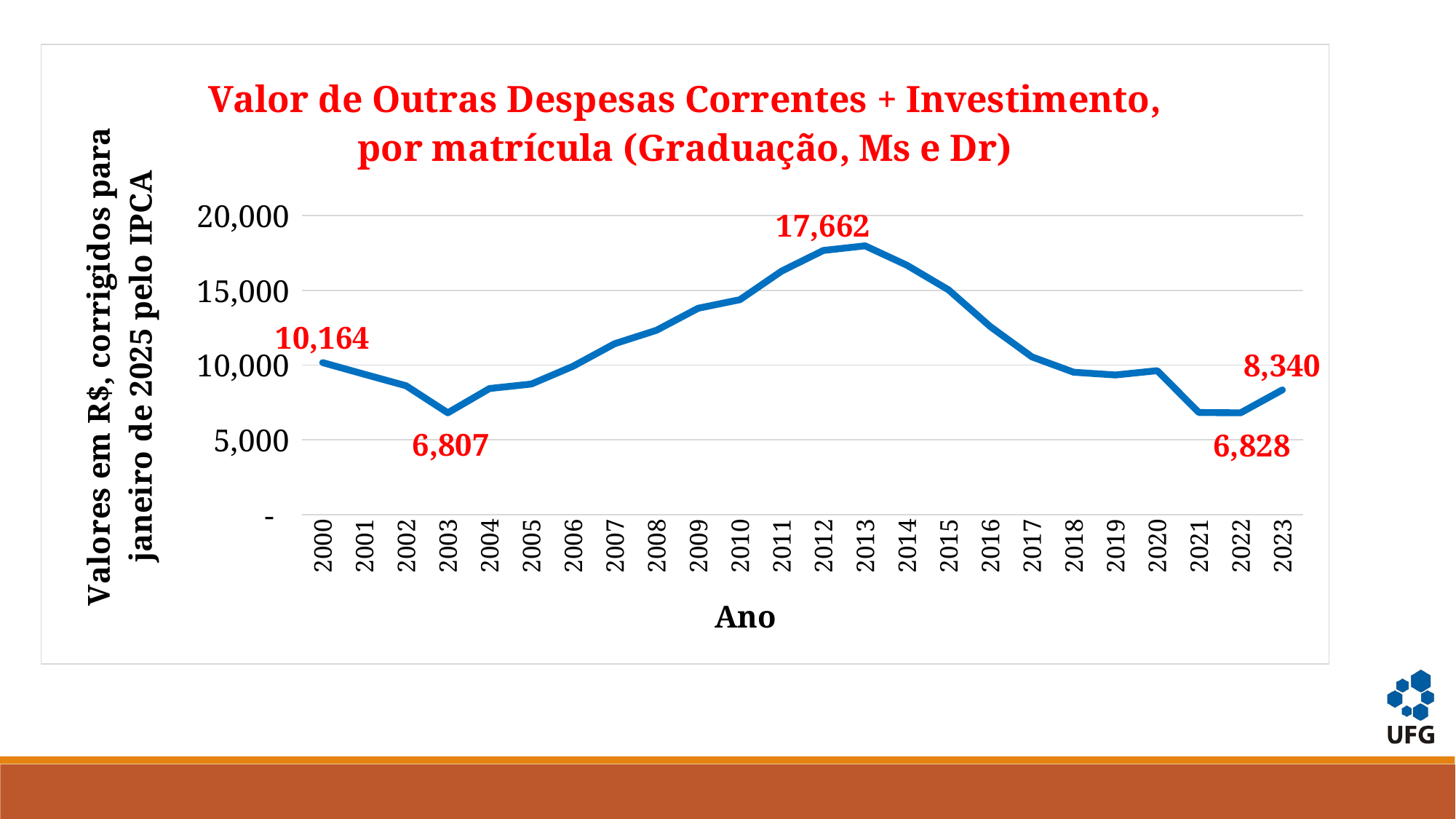
Which is larger, the value for 2000 or the value for 2023? 2000 What is the value for 2023? 8,340 What is the value for 2000? 10,164 Which year has the highest value? 2013 What kind of chart is this? line chart Is the value for 2010 greater or less than 10,000? greater Is the value for 2017 greater or less than 15,000? less What is the value for 2003? 6,807 How many years are shown on the x axis? 24 What is the difference between the values for 2000 and 2003? 3,357